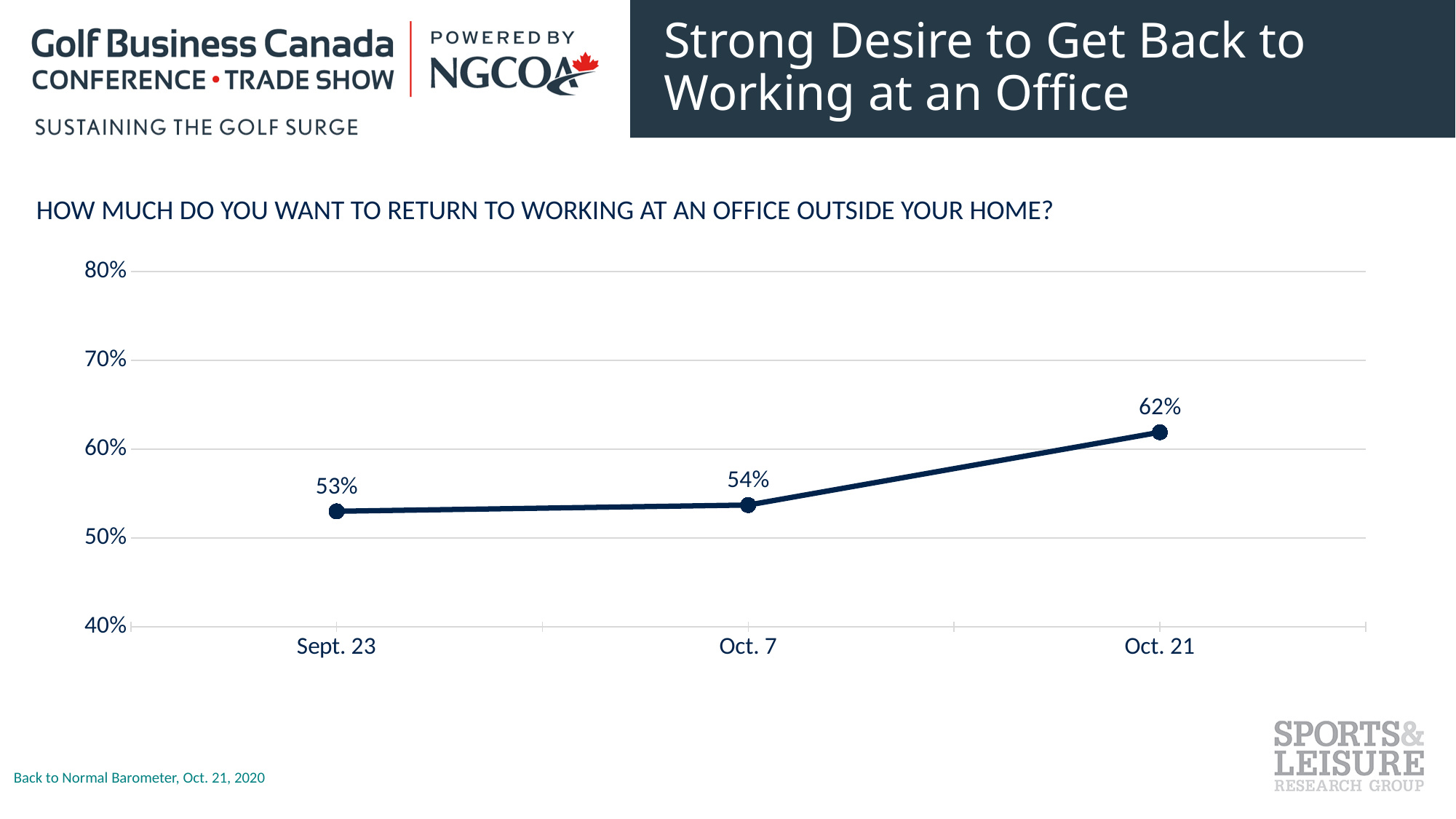
What is the difference between the values for Oct. 21 and Oct. 7? 8% What kind of chart is shown on the slide? line chart Which date has the lowest value? Sept. 23 What is the value for Sept. 23? 53% Which date has the highest value? Oct. 21 Which is larger, the value for Oct. 21 or the value for Sept. 23? Oct. 21 What is the difference between the values for Oct. 7 and Sept. 23? 1% What is the value for Oct. 7? 54% Do the values rise or fall from Sept. 23 to Oct. 21? rise Is the value for Oct. 21 greater or less than 60%? greater How many data points are plotted on the chart? 3 What is the value for Oct. 21? 62%